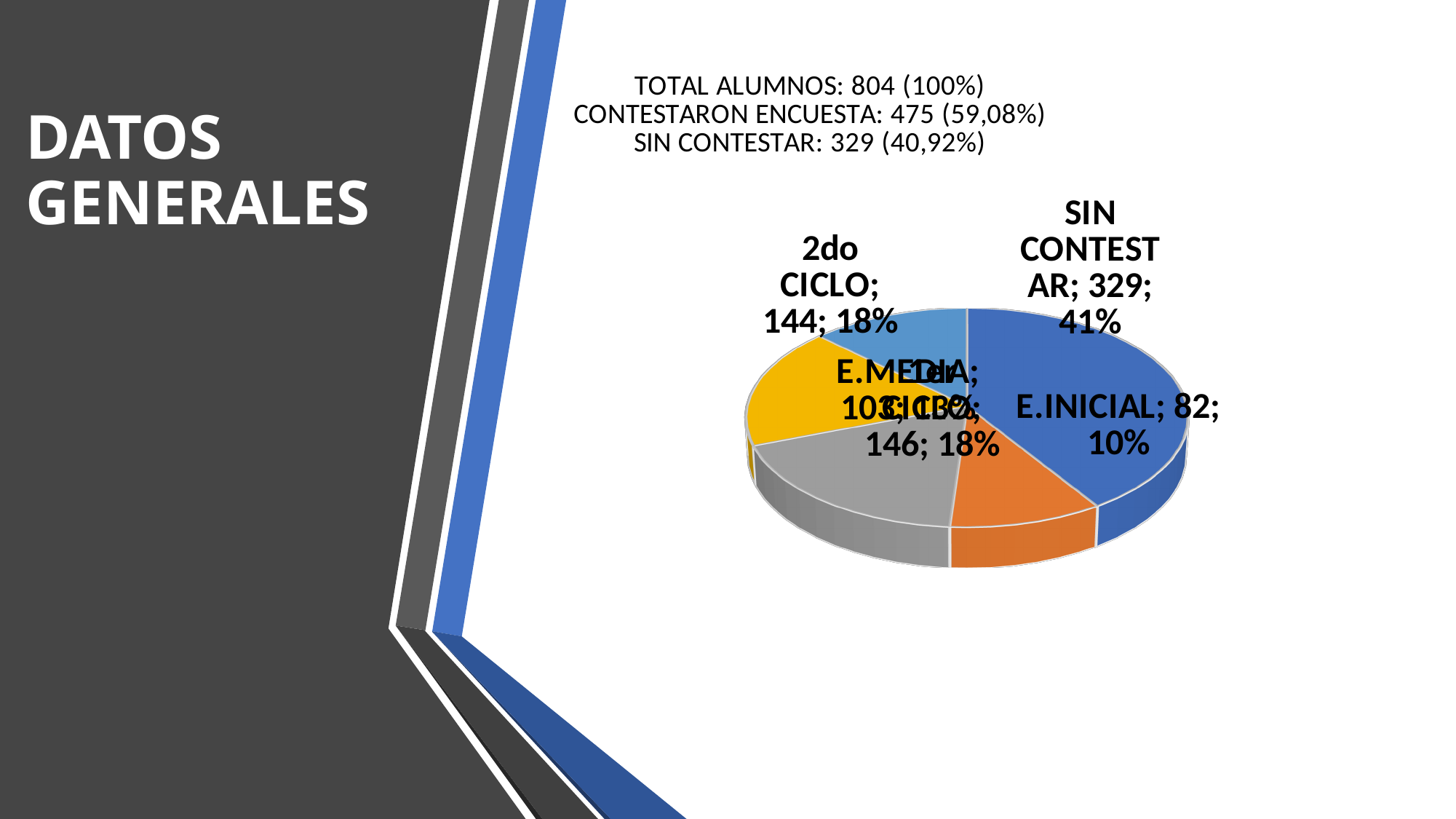
How many slices does the pie chart have? 5 Which category has the largest slice in the pie chart? SIN CONTESTAR Which is larger, the value for SIN CONTESTAR or the value for 2do CICLO? SIN CONTESTAR What share of the pie does SIN CONTESTAR represent? 41% What share of the pie does E.INICIAL represent? 10% What is the difference between the values for SIN CONTESTAR and E.INICIAL? 247 What kind of chart is shown on the slide? pie chart What colour is the SIN CONTESTAR slice in the pie chart? blue Which category has the smallest slice in the pie chart? E.INICIAL What is the value for E.INICIAL in the pie chart? 82 What is the value for SIN CONTESTAR in the pie chart? 329 What is the value for 2do CICLO in the pie chart? 144